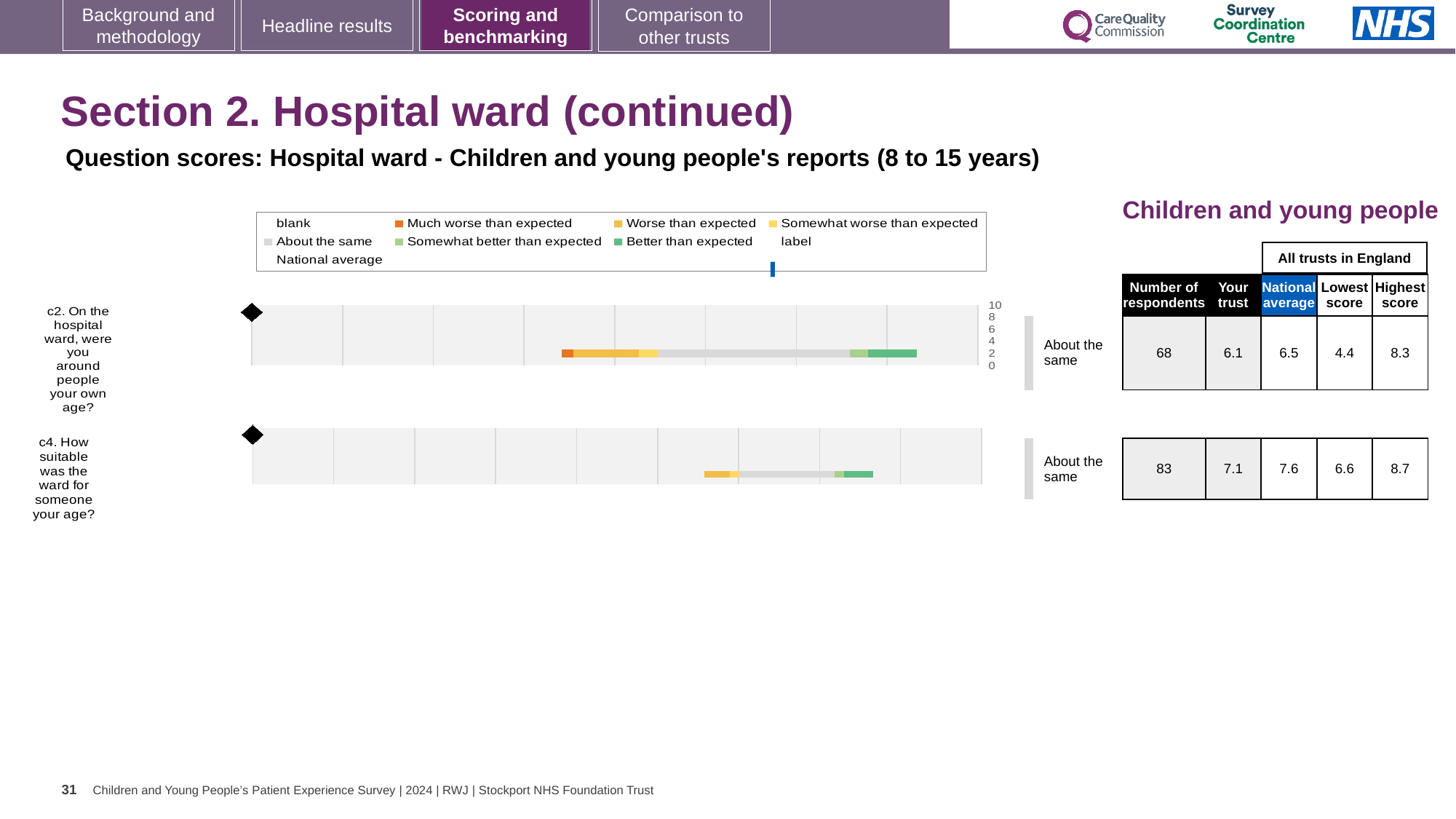
How many questions are plotted on the slide? 2 Which question has more respondents, c2 or c4? c4 What is the national average score for c2? 6.5 What is the difference between the highest and lowest scores for c2? 3.9 What is the highest score among all trusts in England for c4? 8.7 Which question has the higher 'Your trust' score, c2 or c4? c4 What is the difference between the national average and the 'Your trust' score for c4? 0.5 How many respondents answered c4 (How suitable was the ward for someone your age?)? 83 What benchmark category is shown for c2? About the same What is the 'Your trust' score for c2 (On the hospital ward, were you around people your own age?)? 6.1 What kind of chart is used to show the question scores for c2 and c4? bar chart What colour in the legend represents 'Better than expected'? green